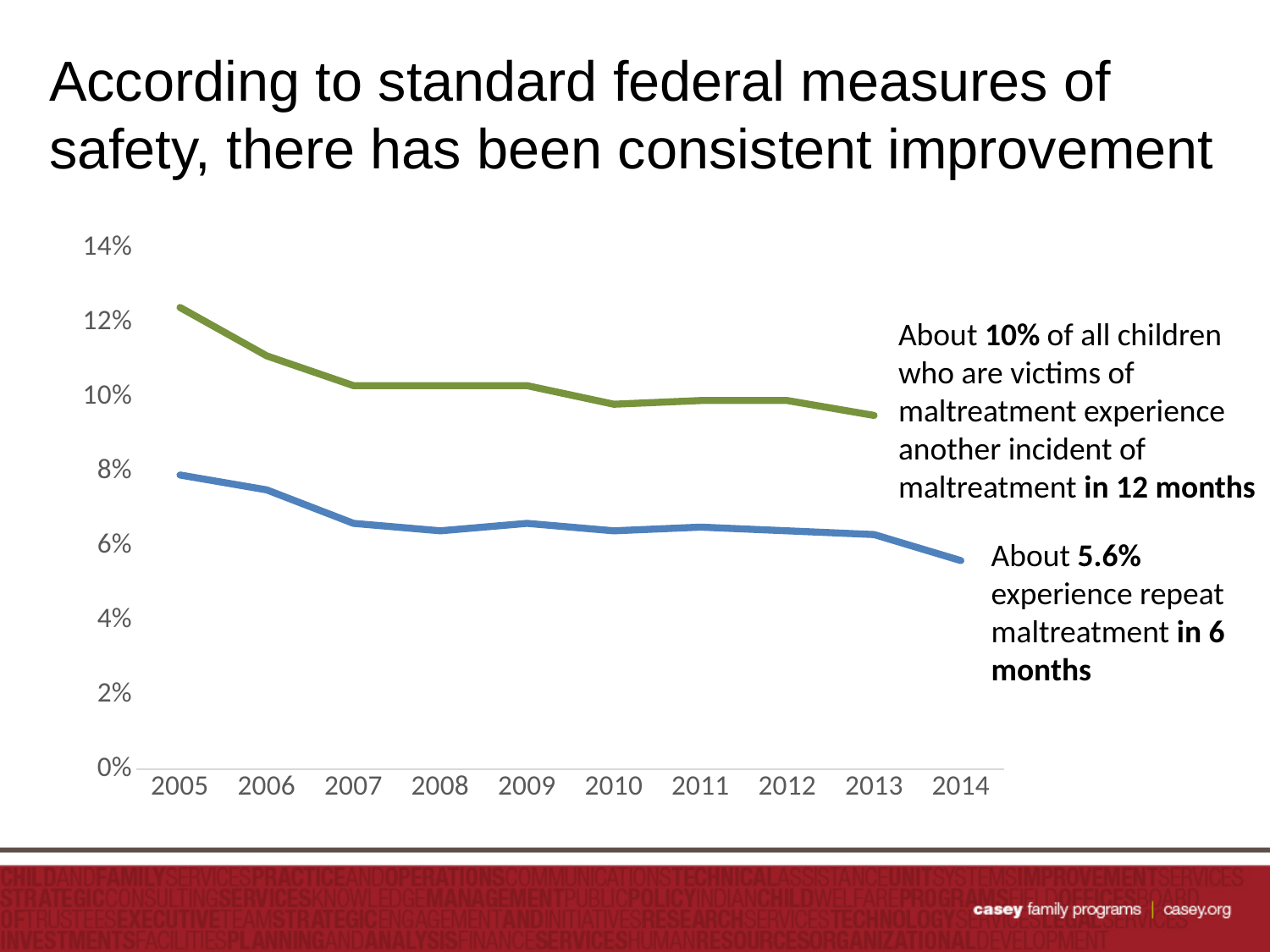
In 2005, which line is higher: the green line (12 months) or the blue line (6 months)? green line (12 months) Does the green line (repeat maltreatment in 12 months) rise or fall from 2005 to 2013? fall What is the first year shown on the x axis? 2005 In which year is the blue line (repeat maltreatment in 6 months) at its lowest? 2014 In which year is the green line (repeat maltreatment in 12 months) at its highest? 2005 What is the last year shown on the x axis? 2014 How many years are shown on the x axis of the chart? 10 Is the value of the green line (12 months) in 2005 greater or less than 10%? greater What kind of chart is shown on the slide? line chart Is the value of the blue line (6 months) in 2014 greater or less than 6%? less How many lines are plotted on the chart? 2 Does the blue line (repeat maltreatment in 6 months) rise or fall from 2005 to 2014? fall